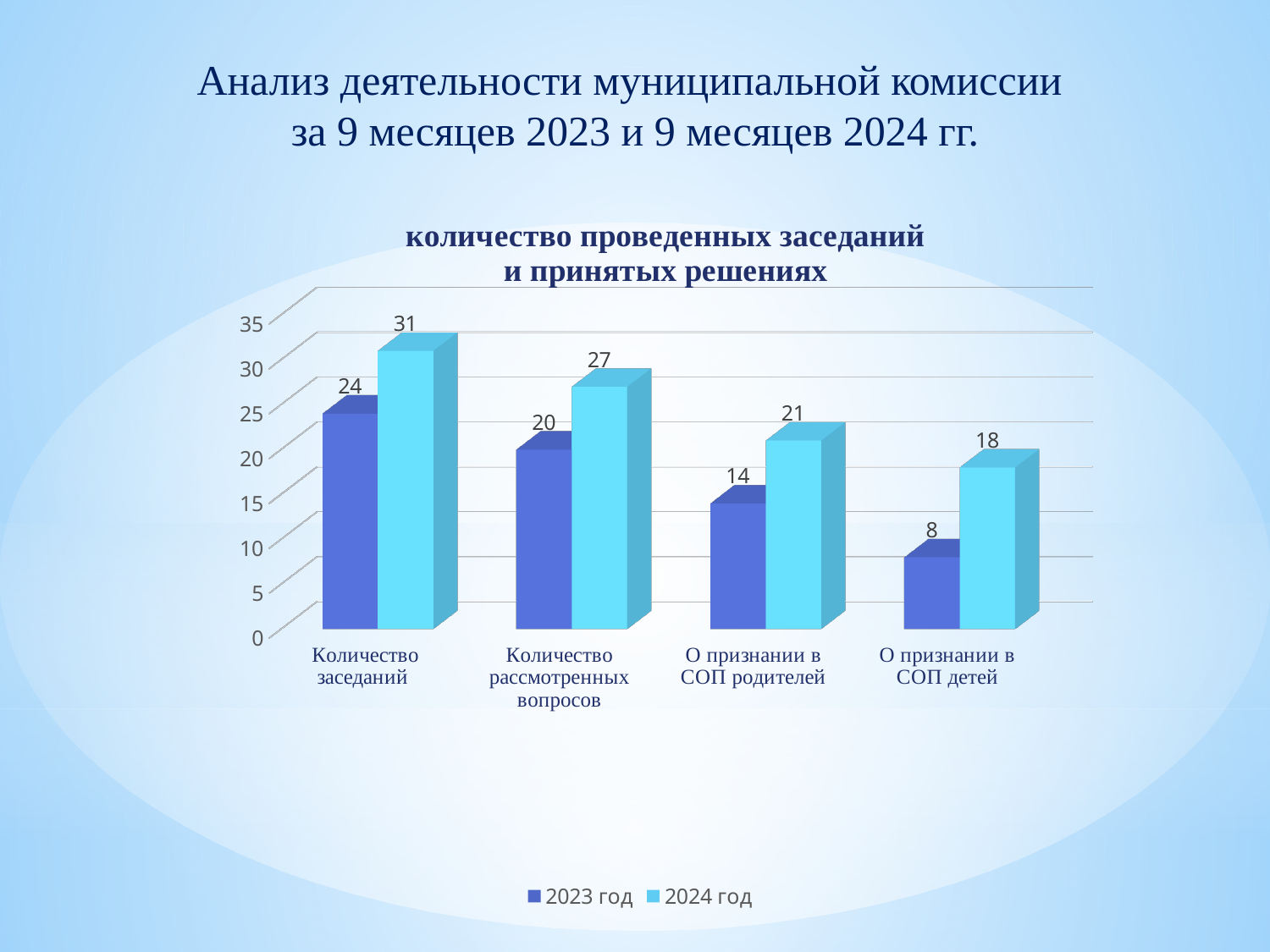
What is the difference between the 2024 год and 2023 год values for О признании в СОП родителей? 7 What is the value for 2023 год in the Количество заседаний category? 24 How many categories are shown on the x axis? 4 Which is larger: the 2023 год value for Количество рассмотренных вопросов or the 2024 год value for О признании в СОП родителей? 2024 год value for О признании в СОП родителей Which category has the highest value for 2024 год? Количество заседаний Do the 2023 год values rise or fall from left to right along the x axis? Fall What is the value for 2024 год in the О признании в СОП детей category? 18 Which category has the lowest value for 2023 год? О признании в СОП детей How many series does the legend list? 2 What is the value for 2024 год in the Количество рассмотренных вопросов category? 27 What kind of chart is shown on the slide? Bar chart What is the difference between the 2024 год and 2023 год values for О признании в СОП детей? 10